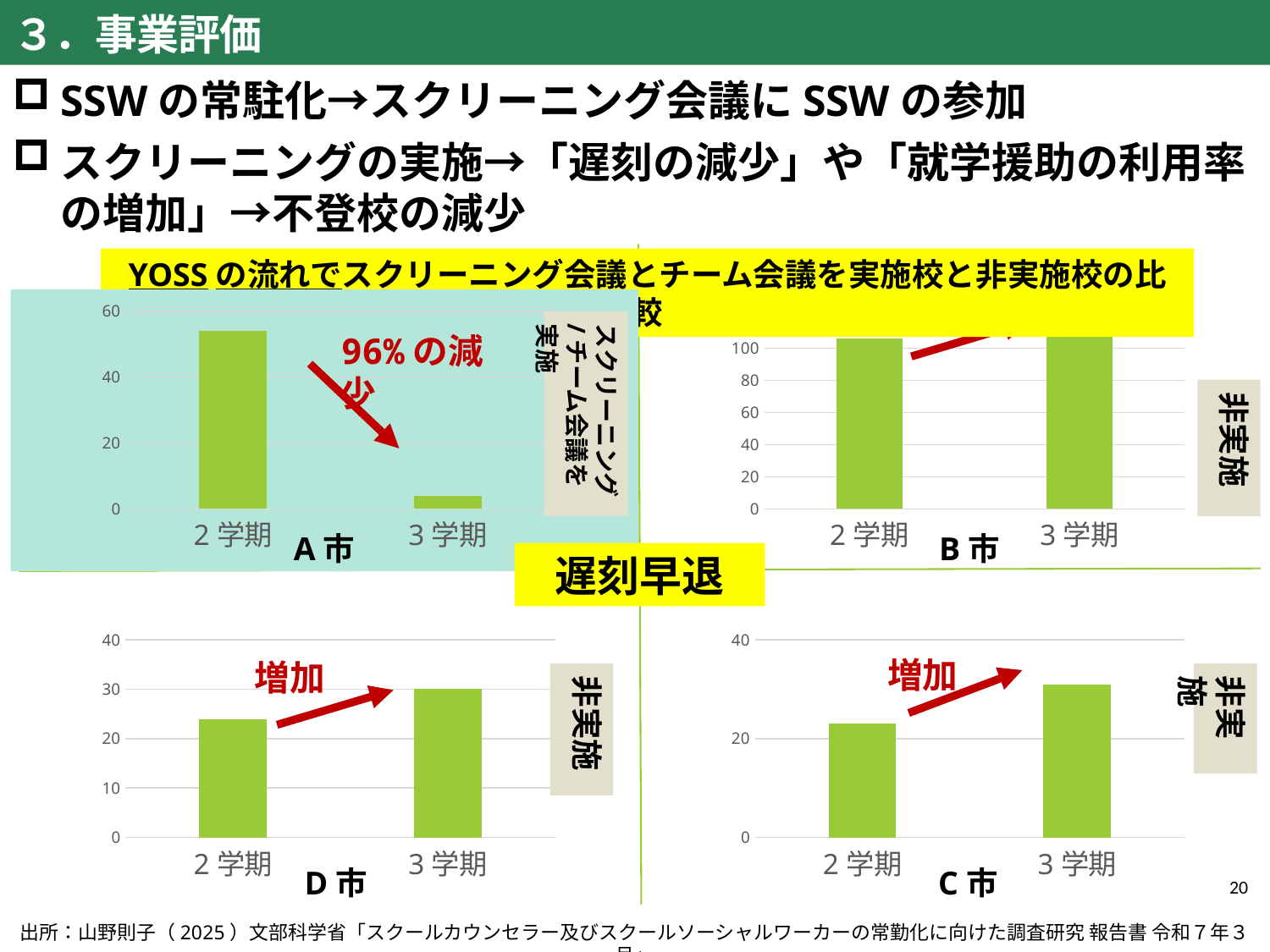
In the A市 chart, do the values rise or fall from 2学期 to 3学期? fall In the A市 chart, which category has the higher bar, 2学期 or 3学期? 2学期 In the A市 chart, is the value for 3学期 greater or less than 20? less In the D市 chart, is the value for 2学期 greater or less than 20? greater In the C市 chart, which category has the lowest bar? 2学期 What kind of chart is the A市 chart? bar chart How many categories are shown on the x axis of the A市 chart? 2 What percentage decrease is annotated on the A市 chart? 96%の減少 In the A市 chart, is the value for 2学期 greater or less than 40? greater In the D市 chart, do the values rise or fall from 2学期 to 3学期? rise